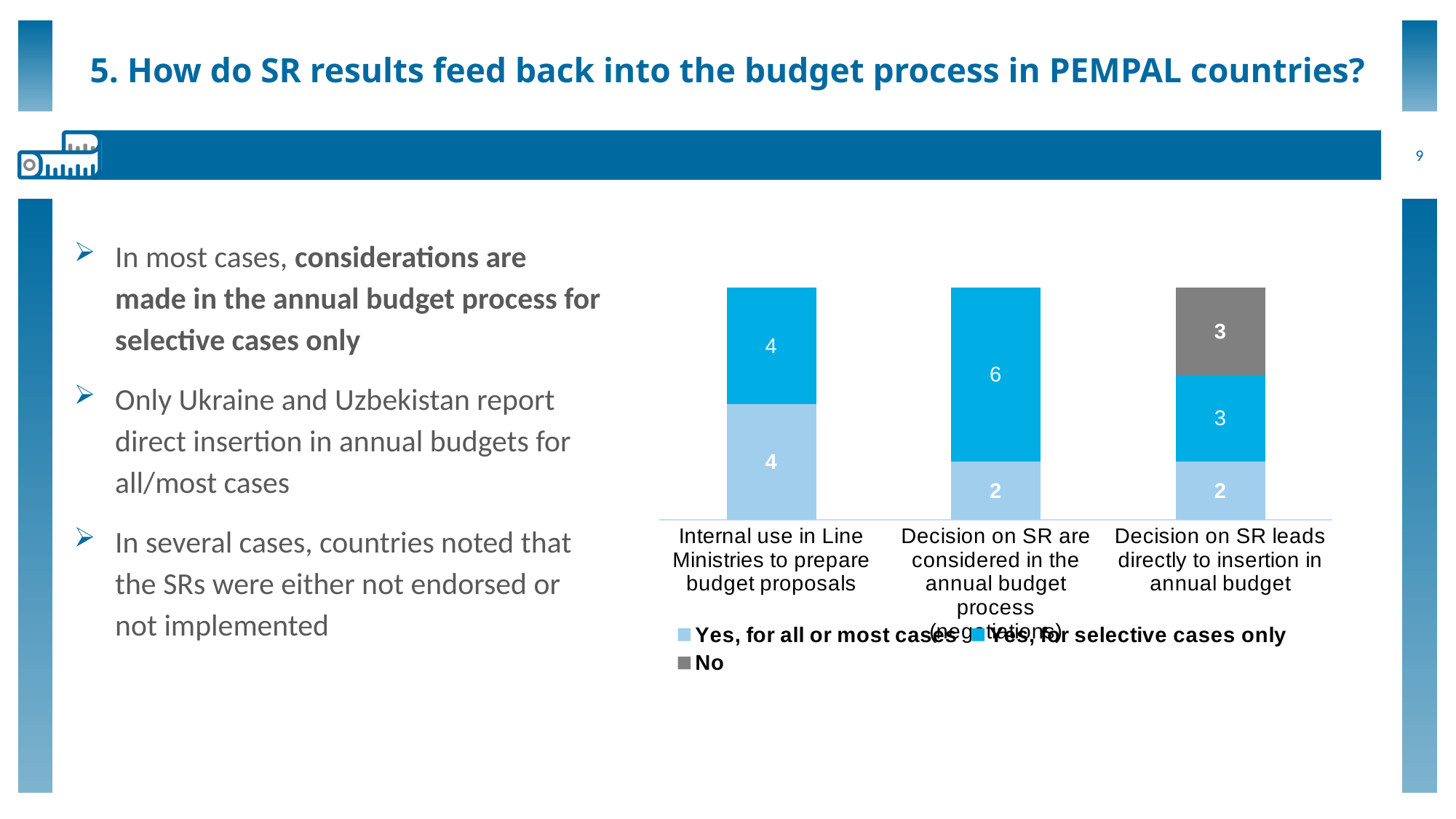
What is the total of the stacked bar for "Decision on SR leads directly to insertion in annual budget"? 8 What is the difference between the "Yes, for selective cases only" values for "Decision on SR are considered in the annual budget process (negotiations)" and "Decision on SR leads directly to insertion in annual budget"? 3 What is the value for "Yes, for selective cases only" in the "Decision on SR are considered in the annual budget process (negotiations)" category? 6 Which category is the only one with a "No" segment in its bar? Decision on SR leads directly to insertion in annual budget What is the value for "Yes, for all or most cases" in the "Internal use in Line Ministries to prepare budget proposals" category? 4 How many series does the chart legend list? 3 What kind of chart is shown on the slide? Stacked bar chart Which category has the highest value for "Yes, for selective cases only"? Decision on SR are considered in the annual budget process (negotiations) What is the value for "No" in the "Decision on SR leads directly to insertion in annual budget" category? 3 Which category has the highest value for "Yes, for all or most cases"? Internal use in Line Ministries to prepare budget proposals How many categories are shown on the x axis of the chart? 3 What is the value for "Yes, for all or most cases" in the "Decision on SR leads directly to insertion in annual budget" category? 2